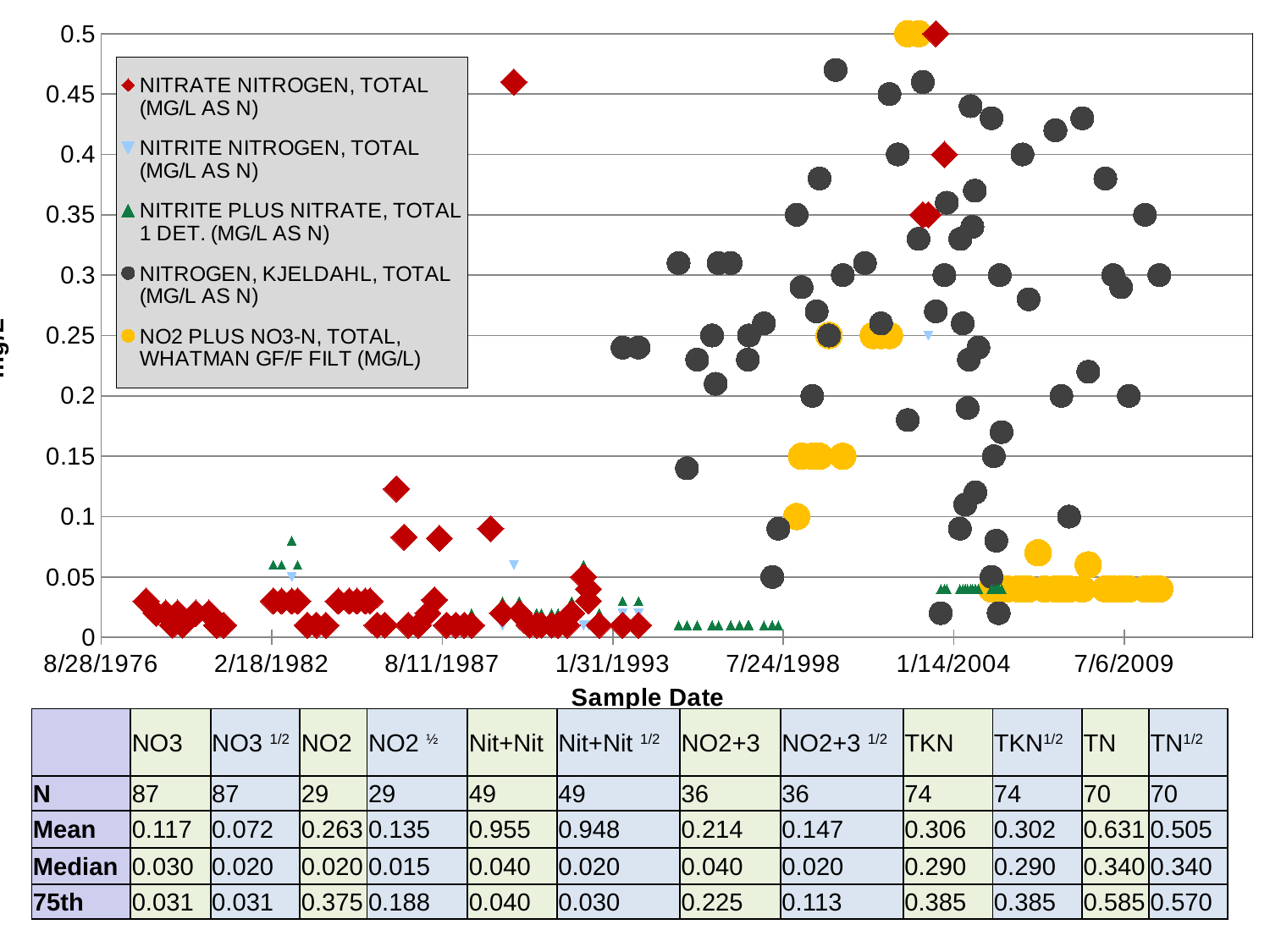
What is the latest date tick shown on the chart's x axis? 7/6/2009 How many series does the chart's legend list? 5 Which series has the most points plotted above 0.3 on the chart? NITROGEN, KJELDAHL, TOTAL (MG/L AS N) What kind of chart is shown on the slide? scatter chart Are the NITRITE PLUS NITRATE, TOTAL 1 DET. values plotted on the chart greater or less than 0.1? less What is the highest tick value shown on the chart's y axis? 0.5 What is the title of the chart's x axis? Sample Date Which series is plotted with yellow circles? NO2 PLUS NO3-N, TOTAL, WHATMAN GF/F FILT (MG/L) In the table below the chart, what is the Mean value for TKN? 0.306 Is the NITRATE NITROGEN, TOTAL point plotted near 1/14/2004 at the top of the chart greater or less than 0.45? greater In the table below the chart, what is the N value for NO3? 87 What is the earliest date tick shown on the chart's x axis? 8/28/1976